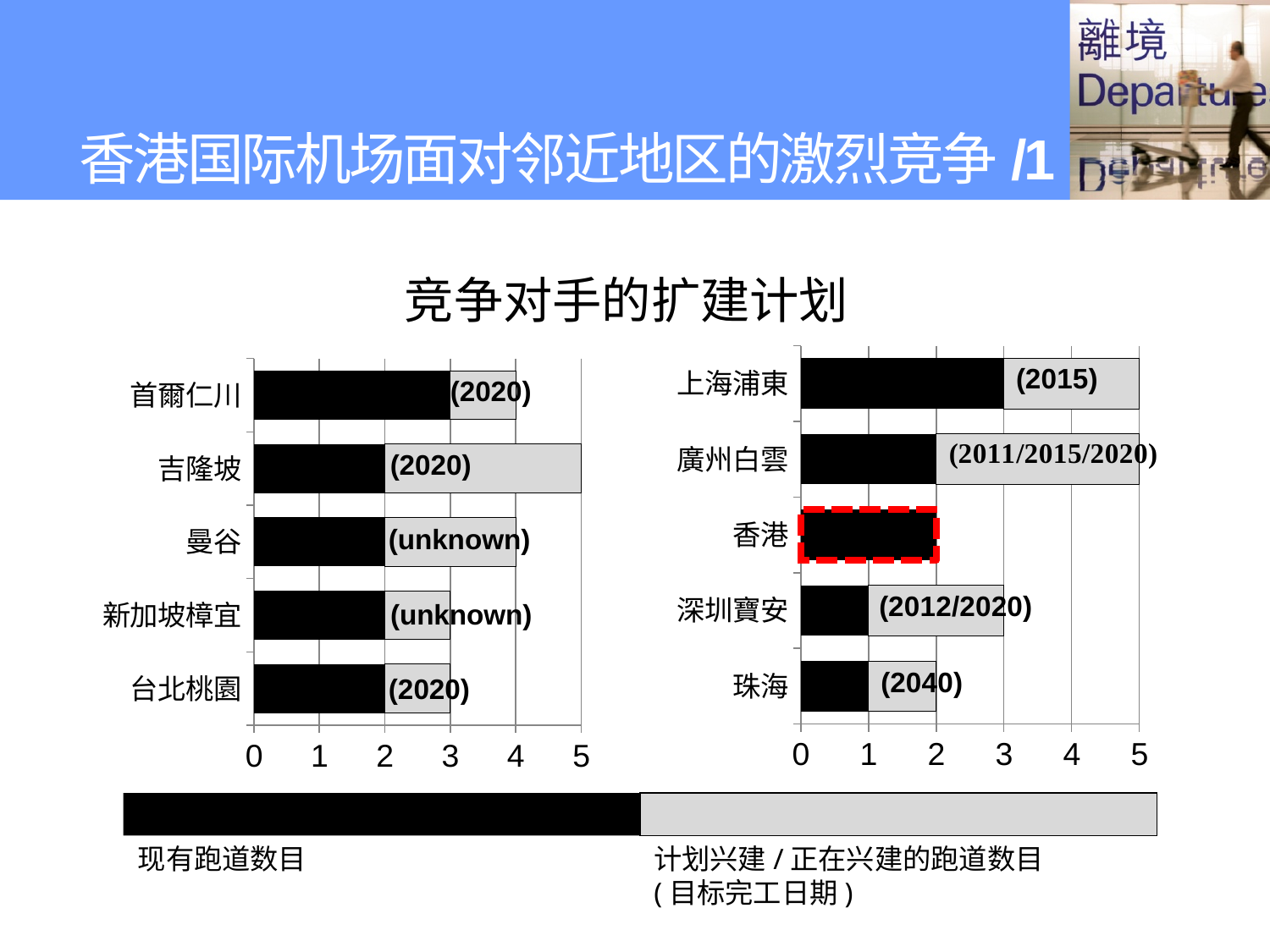
What type of chart is used on this slide? Bar chart How many airports are listed in the right chart? 5 In the right chart, how many existing runways (现有跑道数目) does 深圳寶安 have? 1 How many series does the legend at the bottom of the slide list? 2 In the left chart, how many existing runways (现有跑道数目) does 首爾仁川 have? 3 In the left chart, which has more existing runways, 首爾仁川 or 台北桃園? 首爾仁川 In the right chart, how many more existing runways does 上海浦東 have than 珠海? 2 In the right chart, what target completion date is printed next to the 珠海 bar? (2040) In the left chart, which airport has the longest total bar? 吉隆坡 In the left chart, what is the total number of runways (existing plus planned) shown for 吉隆坡? 5 In the right chart, what is the total number of runways (existing plus planned) shown for 廣州白雲? 5